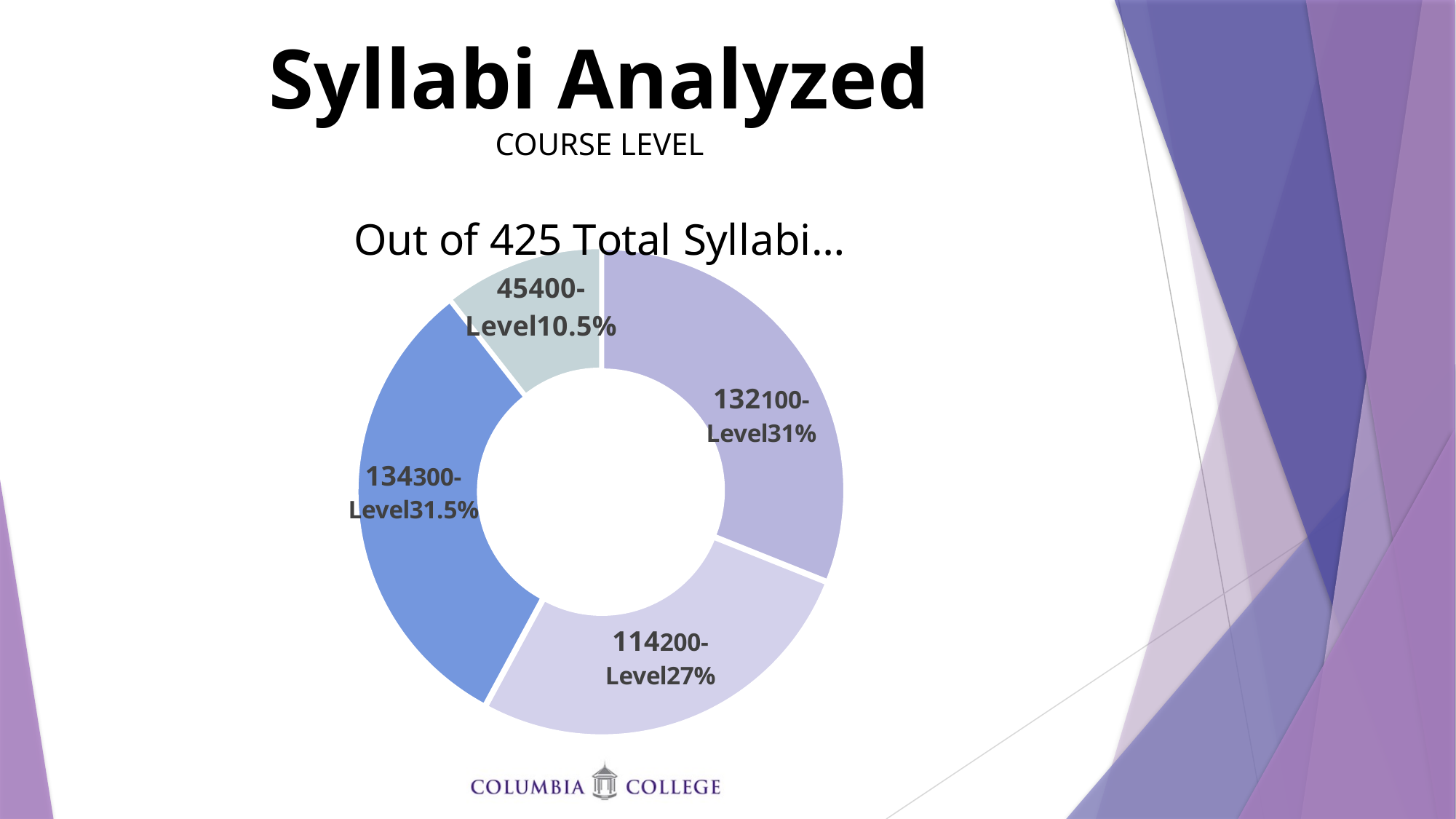
What percentage of the syllabi are 400-Level? 10.5% What is the difference between the number of 300-Level and 400-Level syllabi? 89 Which has more syllabi, 100-Level or 200-Level? 100-Level How many course-level categories does the chart show? 4 How many syllabi are 400-Level? 45 What is the chart's title? Out of 425 Total Syllabi... How many syllabi are 100-Level? 132 How many syllabi are 200-Level? 114 Which course level has the fewest syllabi? 400-Level What percentage of the syllabi are 300-Level? 31.5% What kind of chart is shown on the slide? Doughnut chart How many syllabi are 300-Level? 134